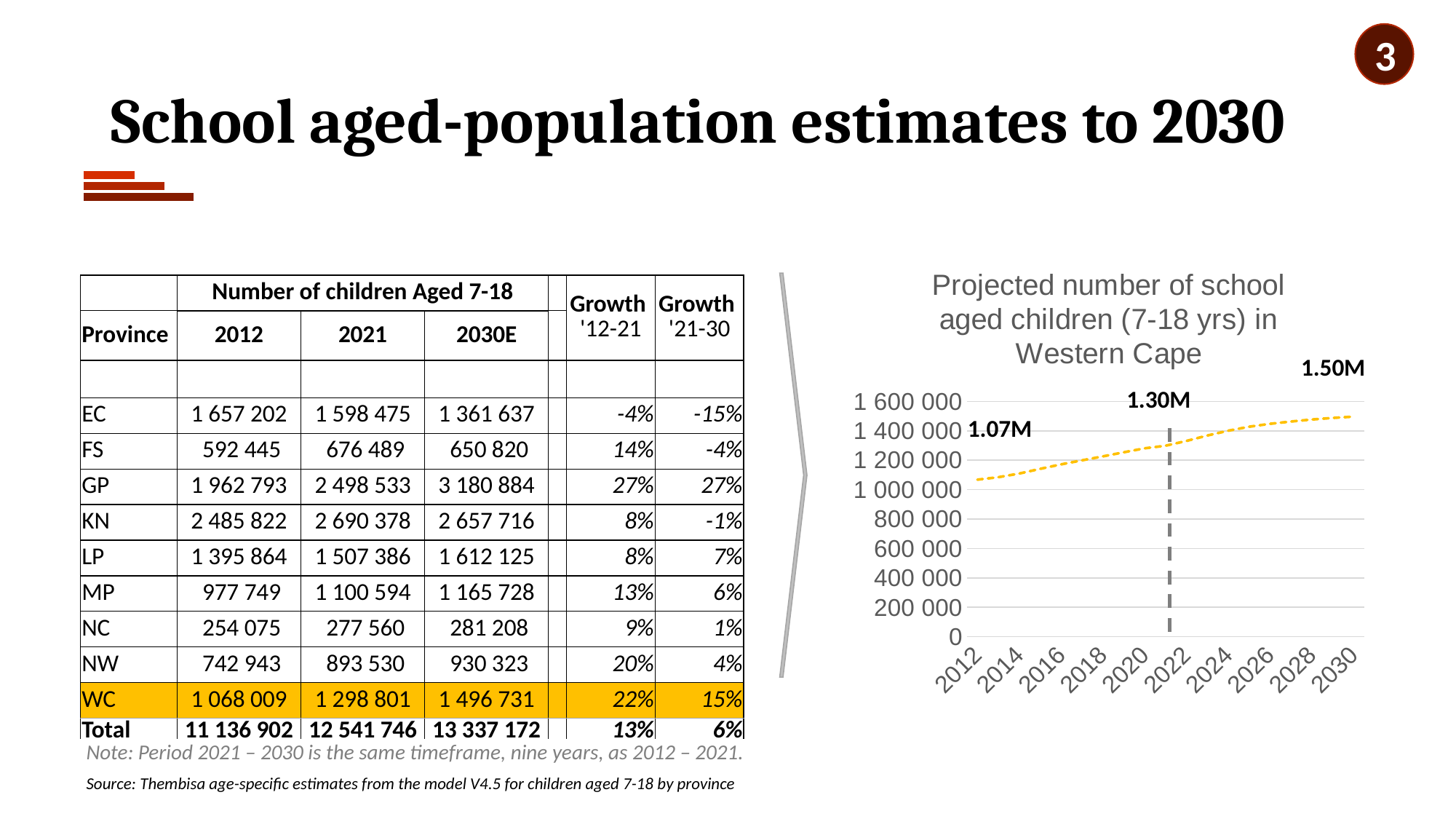
In the Western Cape chart, what value is labelled at the vertical dashed line? 1.30M What kind of chart is shown on the right of the slide? line chart How many year labels are shown on the x axis of the Western Cape chart? 10 In the Western Cape chart, which year has the higher value, 2012 or 2030? 2030 In the Western Cape chart, what value is labelled at the end of the line in 2030? 1.50M In the Western Cape chart, is the value for 2012 greater or less than 1 000 000? greater In the Western Cape chart, which year shown on the x axis has the highest value? 2030 In the Western Cape chart, is the value for 2030 greater or less than 1 600 000? less What is the title of the chart on the right of the slide? Projected number of school aged children (7-18 yrs) in Western Cape In the Western Cape chart, what value is labelled at the start of the line in 2012? 1.07M In the Western Cape chart, what is the difference between the labelled 2030 value and the labelled 2012 value? 0.43M In the Western Cape chart, does the projected number of school aged children rise or fall from 2012 to 2030? rise